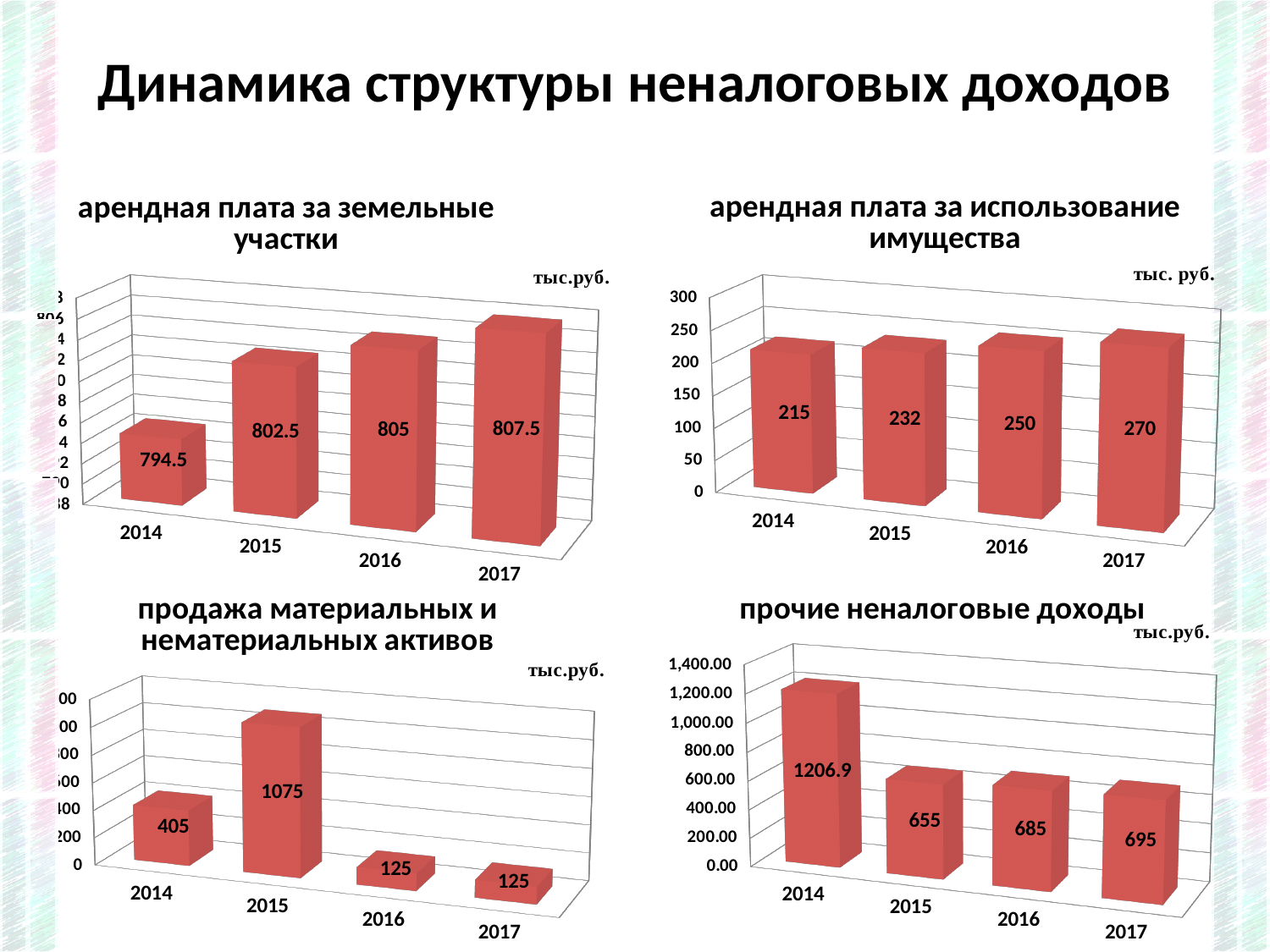
In the chart titled "прочие неналоговые доходы", which year has the lowest value? 2015 In the chart titled "арендная плата за земельные участки", what is the value for 2014? 794.5 In the chart titled "прочие неналоговые доходы", which is larger, the value for 2016 or the value for 2017? 2017 In the chart titled "прочие неналоговые доходы", what is the value for 2014? 1206.9 In the chart titled "арендная плата за использование имущества", what is the value for 2016? 250 In the chart titled "продажа материальных и нематериальных активов", which year has the highest value? 2015 In the chart titled "арендная плата за использование имущества", is the value for 2015 greater or less than 250? less In the chart titled "арендная плата за земельные участки", do the values rise or fall from 2014 to 2017? rise In the chart titled "продажа материальных и нематериальных активов", how many years are shown on the x axis? 4 In the chart titled "арендная плата за земельные участки", which year has the highest value? 2017 In the chart titled "продажа материальных и нематериальных активов", what is the value for 2015? 1075 In the chart titled "арендная плата за использование имущества", what is the difference between the 2017 and 2014 values? 55